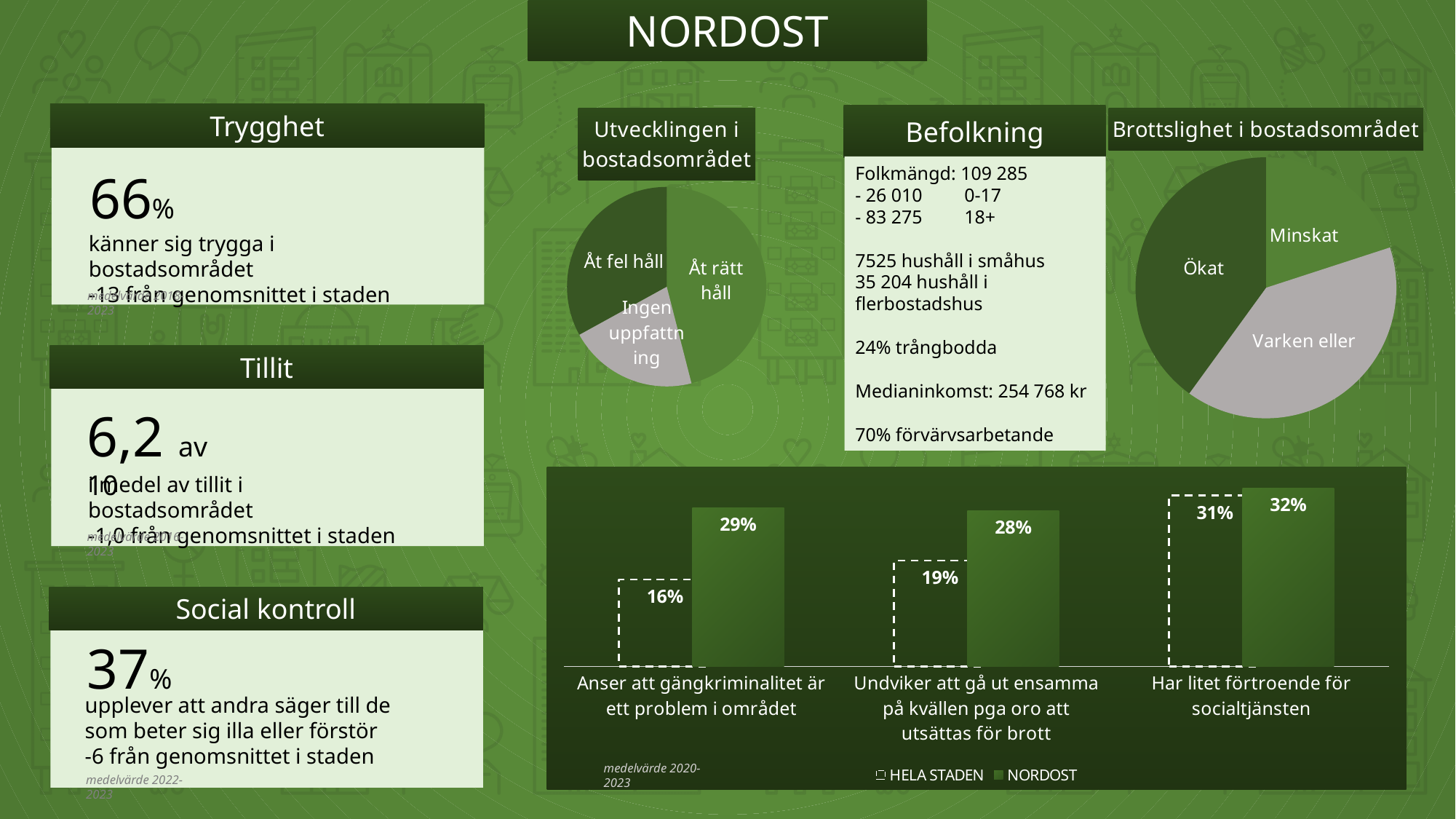
In the bar chart at the bottom of the slide, what is the HELA STADEN value for "Undviker att gå ut ensamma på kvällen pga oro att utsättas för brott"? 19% In the pie chart "Utvecklingen i bostadsområdet", which slice is the largest? Åt rätt håll How many series does the legend of the bar chart at the bottom of the slide list? 2 In the pie chart "Utvecklingen i bostadsområdet", which slice is the smallest? Ingen uppfattning In the pie chart "Brottslighet i bostadsområdet", which slice is the smallest? Minskat In the bar chart at the bottom of the slide, which category has the highest NORDOST value? Har litet förtroende för socialtjänsten In the bar chart at the bottom of the slide, which series has the larger value for "Undviker att gå ut ensamma på kvällen pga oro att utsättas för brott", HELA STADEN or NORDOST? NORDOST In the bar chart at the bottom of the slide, what is the NORDOST value for "Har litet förtroende för socialtjänsten"? 32% In the bar chart at the bottom of the slide, what is the NORDOST value for "Anser att gängkriminalitet är ett problem i området"? 29% What kind of chart is the chart at the bottom of the slide with the HELA STADEN and NORDOST legend? Bar chart How many categories are shown in the bar chart at the bottom of the slide? 3 In the bar chart at the bottom of the slide, what is the difference between the NORDOST and HELA STADEN values for "Anser att gängkriminalitet är ett problem i området"? 13 percentage points